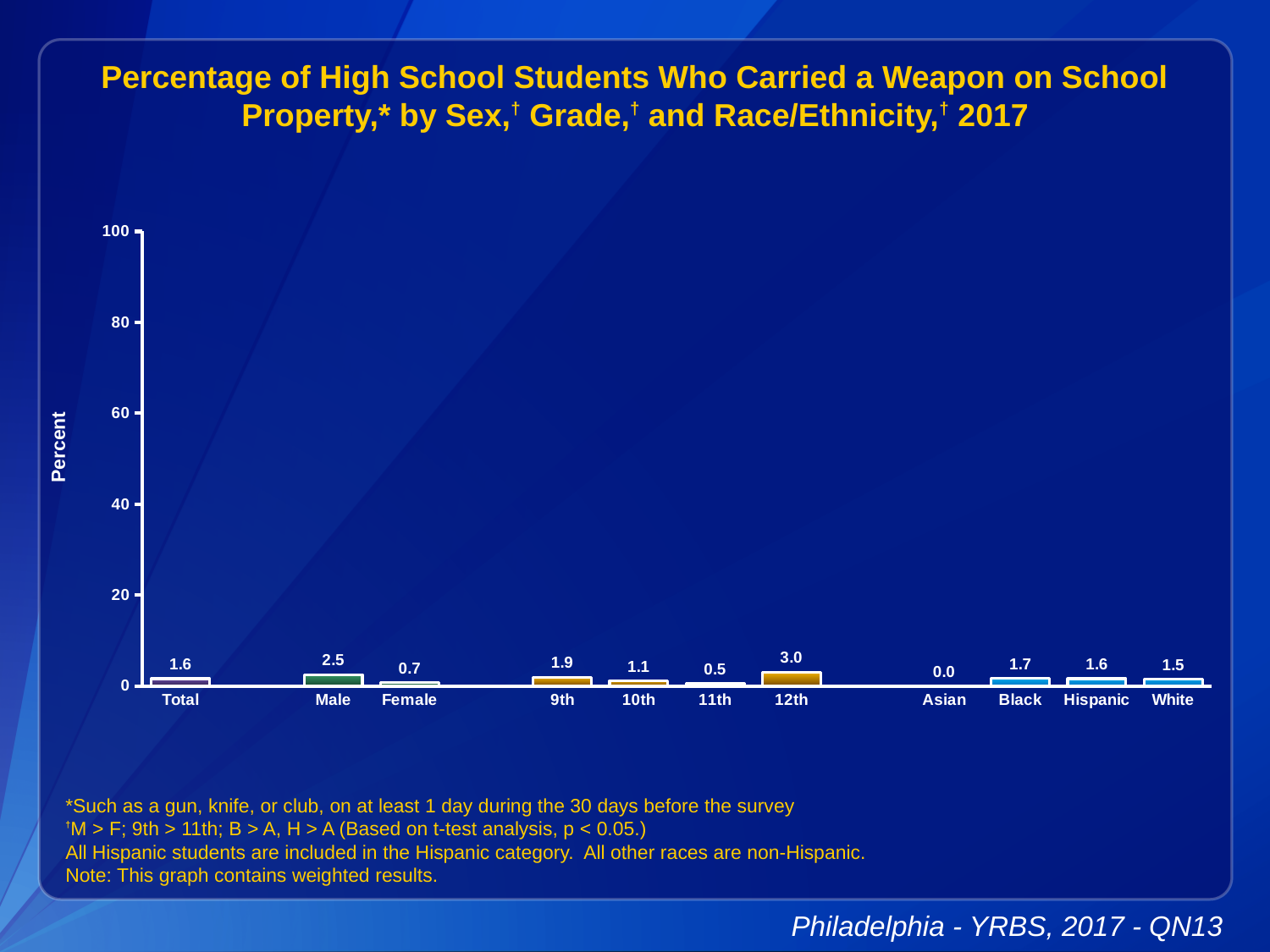
Which category has the lowest value? Asian What is the value for Asian students? 0.0 What is the value for Male? 2.5 Is the value for Black students greater or less than 20? less How many categories are shown on the x axis? 11 Which is larger, the value for 9th grade or the value for 11th grade? 9th What is the value for Total? 1.6 What is the label on the y axis? Percent What is the value for 12th grade? 3.0 Which category has the highest value? 12th What is the difference between the Male and Female values? 1.8 What kind of chart is this? bar chart